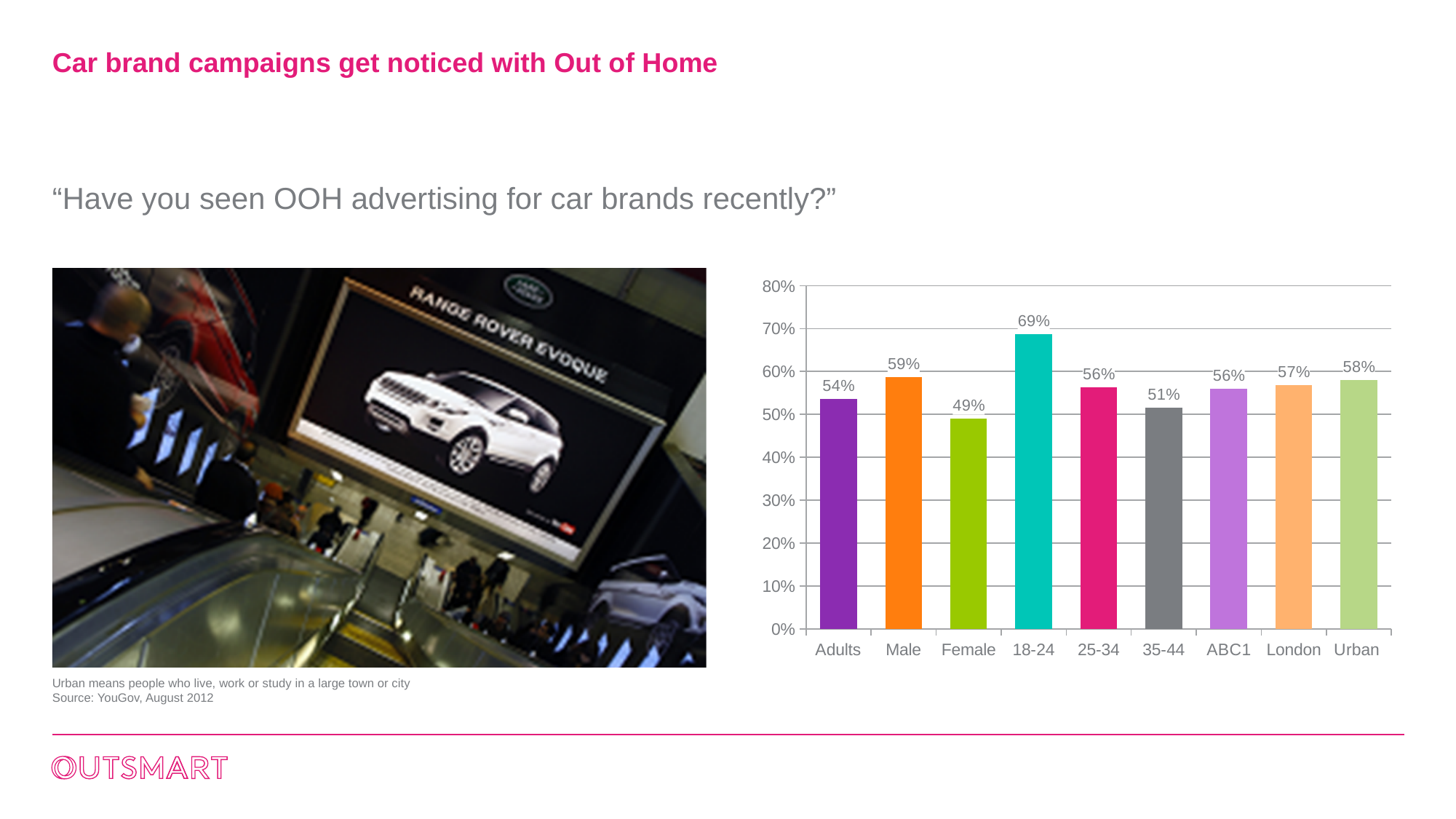
Which category has the lowest value? Female What is the value shown for London? 57% What is the value shown for Female? 49% How many categories are shown on the x axis? 9 Which is larger, the value for Urban or the value for ABC1? Urban What is the difference between the Male and Female values? 10% What is the highest value shown on the y axis? 80% What kind of chart is shown on the slide? Bar chart What percentage of 18-24 year olds said they had seen OOH advertising for car brands recently? 69% What is the difference between the 18-24 and 35-44 values? 18% Which category has the highest value? 18-24 What is the value shown for Adults? 54%